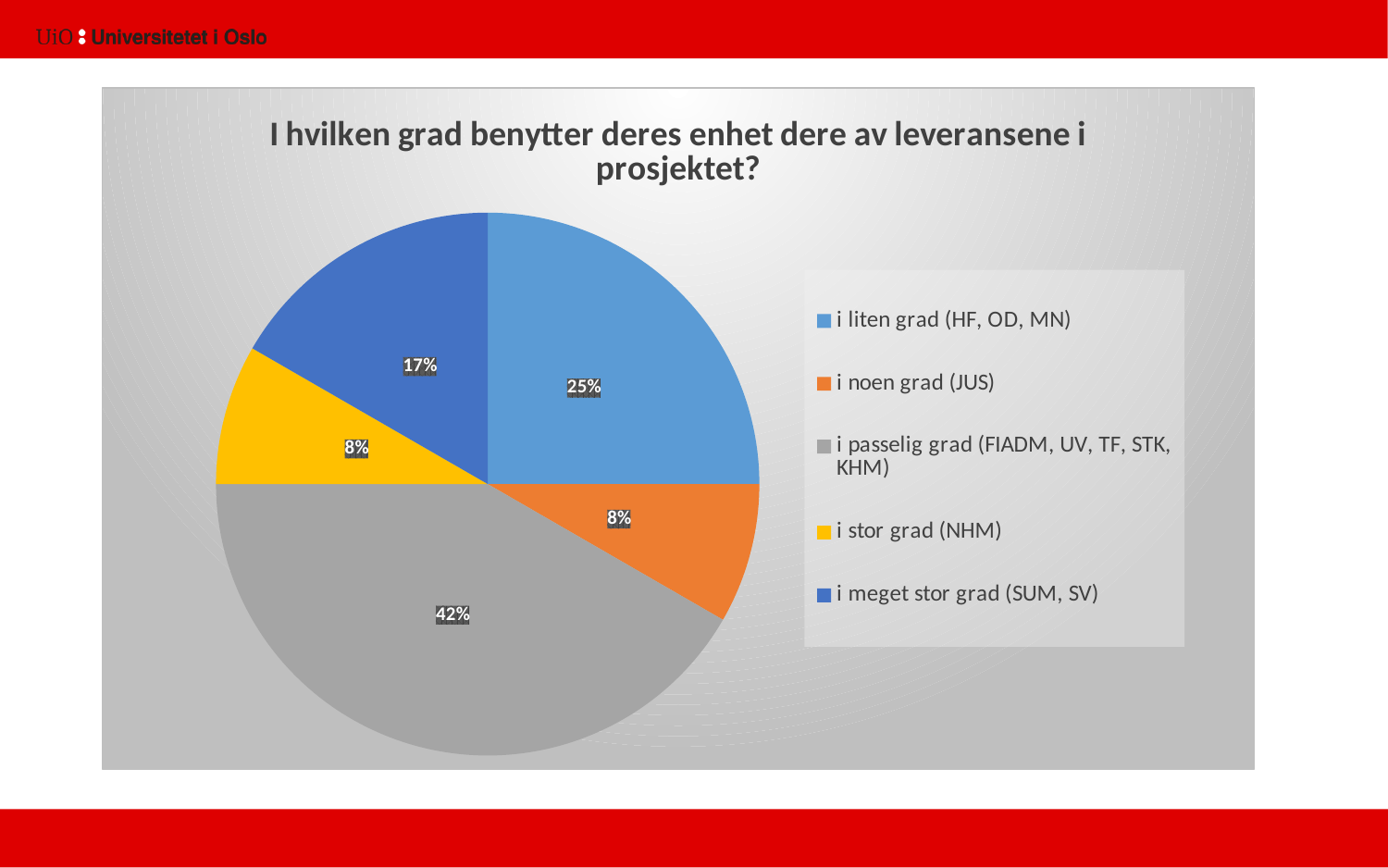
What is the title of the chart? I hvilken grad benytter deres enhet dere av leveransene i prosjektet? What share of the pie is 'i passelig grad (FIADM, UV, TF, STK, KHM)'? 42% Which is larger, the share for 'i liten grad (HF, OD, MN)' or the share for 'i meget stor grad (SUM, SV)'? i liten grad (HF, OD, MN) Which category has the largest slice? i passelig grad (FIADM, UV, TF, STK, KHM) How many slices does the pie chart have? 5 What share of the pie is 'i meget stor grad (SUM, SV)'? 17% What is the difference between the shares for 'i passelig grad (FIADM, UV, TF, STK, KHM)' and 'i liten grad (HF, OD, MN)'? 17% What share of the pie is 'i stor grad (NHM)'? 8% What kind of chart is shown on the slide? pie chart What colour is the slice for 'i stor grad (NHM)'? yellow